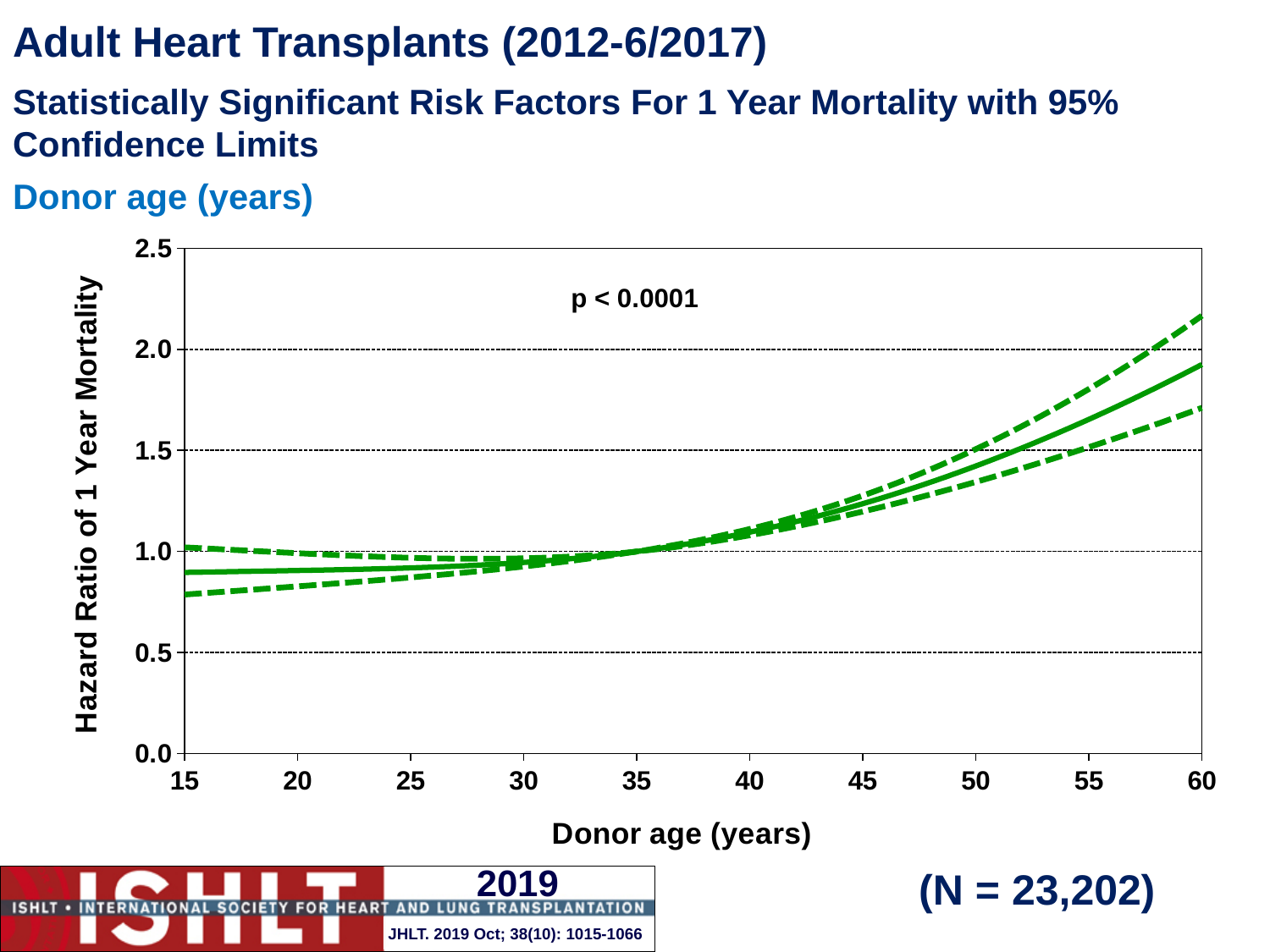
Is the hazard ratio (solid line) at a donor age of 45 years greater or less than 1.0? greater Is the hazard ratio (solid line) at a donor age of 30 years greater or less than 1.0? less How many donor age tick labels are shown on the x axis? 10 What is the label of the y axis? Hazard Ratio of 1 Year Mortality Is the hazard ratio (solid line) at a donor age of 15 years greater or less than 1.0? less Does the hazard ratio of 1 year mortality rise or fall as donor age increases from 35 to 60 years? Rise What p-value is printed on the chart? p < 0.0001 What kind of chart is shown on the slide? Line chart